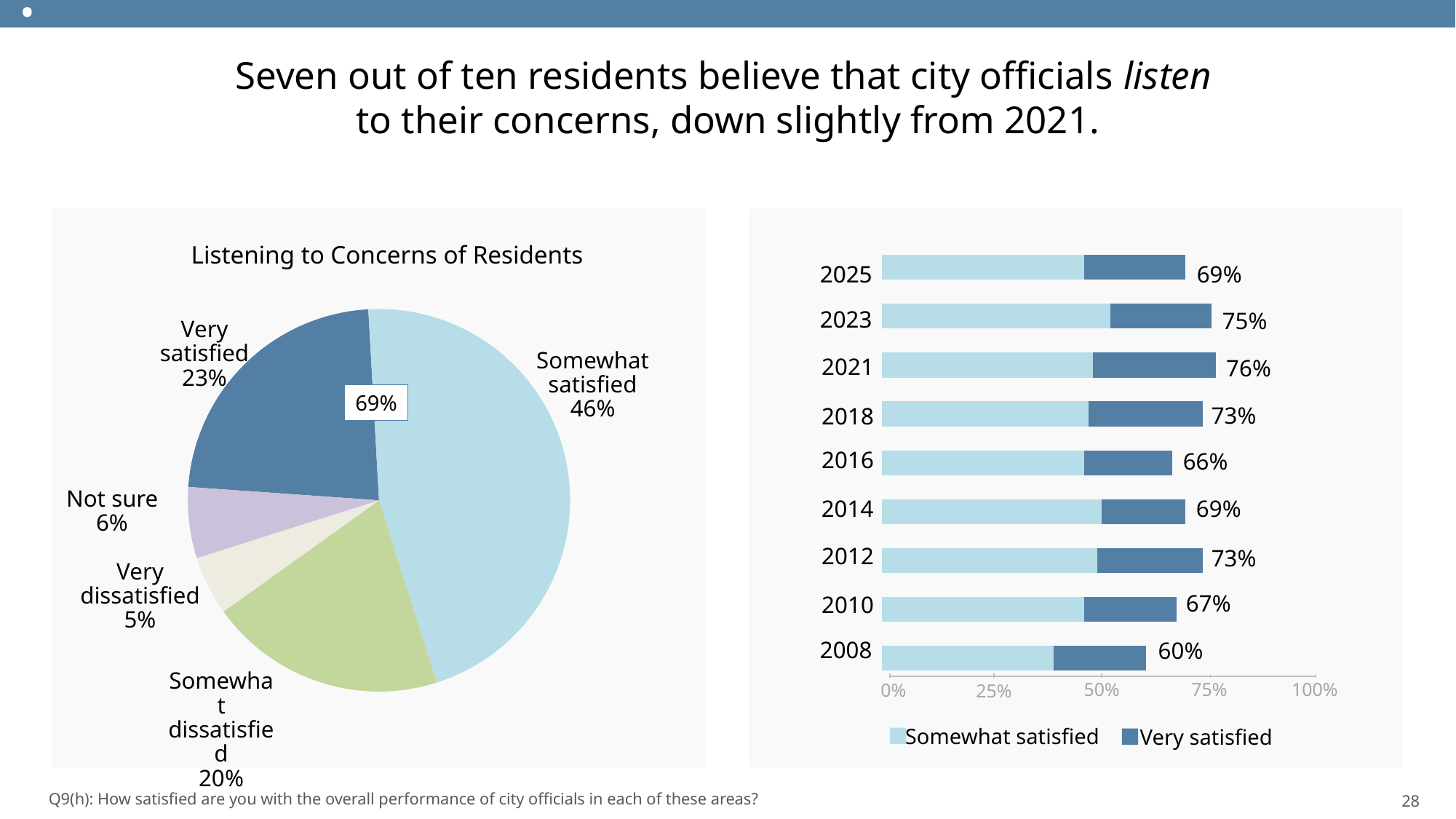
In the pie chart titled 'Listening to Concerns of Residents', how many slices are there? 5 In the pie chart titled 'Listening to Concerns of Residents', what is the difference between the somewhat satisfied and somewhat dissatisfied shares? 26% In the bar chart on the right, how many years are shown? 9 In the pie chart titled 'Listening to Concerns of Residents', which category has the largest share? Somewhat satisfied In the pie chart titled 'Listening to Concerns of Residents', what percentage of residents are very satisfied? 23% In the bar chart on the right, which year has the highest total satisfied percentage? 2021 In the bar chart on the right, how many series does the legend list? 2 In the pie chart titled 'Listening to Concerns of Residents', which category has the smallest share? Very dissatisfied In the pie chart titled 'Listening to Concerns of Residents', what percentage of residents are somewhat satisfied? 46% In the bar chart on the right, what is the total satisfied percentage for 2025? 69% In the bar chart on the right, what is the total satisfied percentage for 2008? 60% In the bar chart on the right, what is the difference between the total for 2021 and the total for 2025? 7%